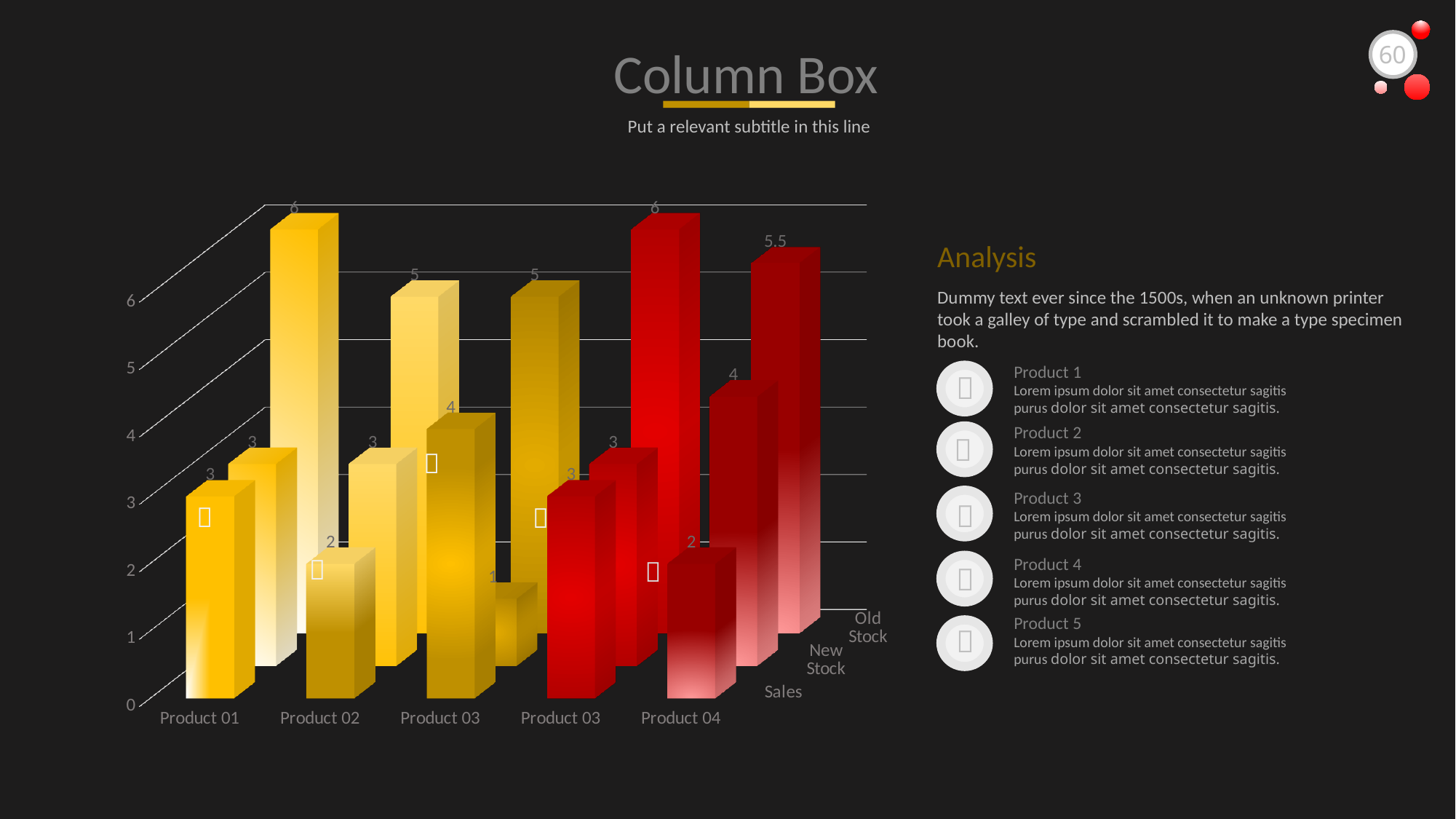
How many categories are plotted along the x axis of the chart? 5 Which category label appears twice on the x axis? Product 03 What is the Old Stock value for Product 01? 6 What is the Sales value for Product 02? 2 What is the difference between the Old Stock value and the Sales value for Product 01? 3 What is the Old Stock value for Product 04? 5.5 Which series has the highest value for Product 04? Old Stock What kind of chart is shown on the slide? bar chart What is the New Stock value for Product 04? 4 What is the Sales value for Product 04? 2 What is the title of the chart slide? Column Box How many series (depth rows) does the chart show? 3